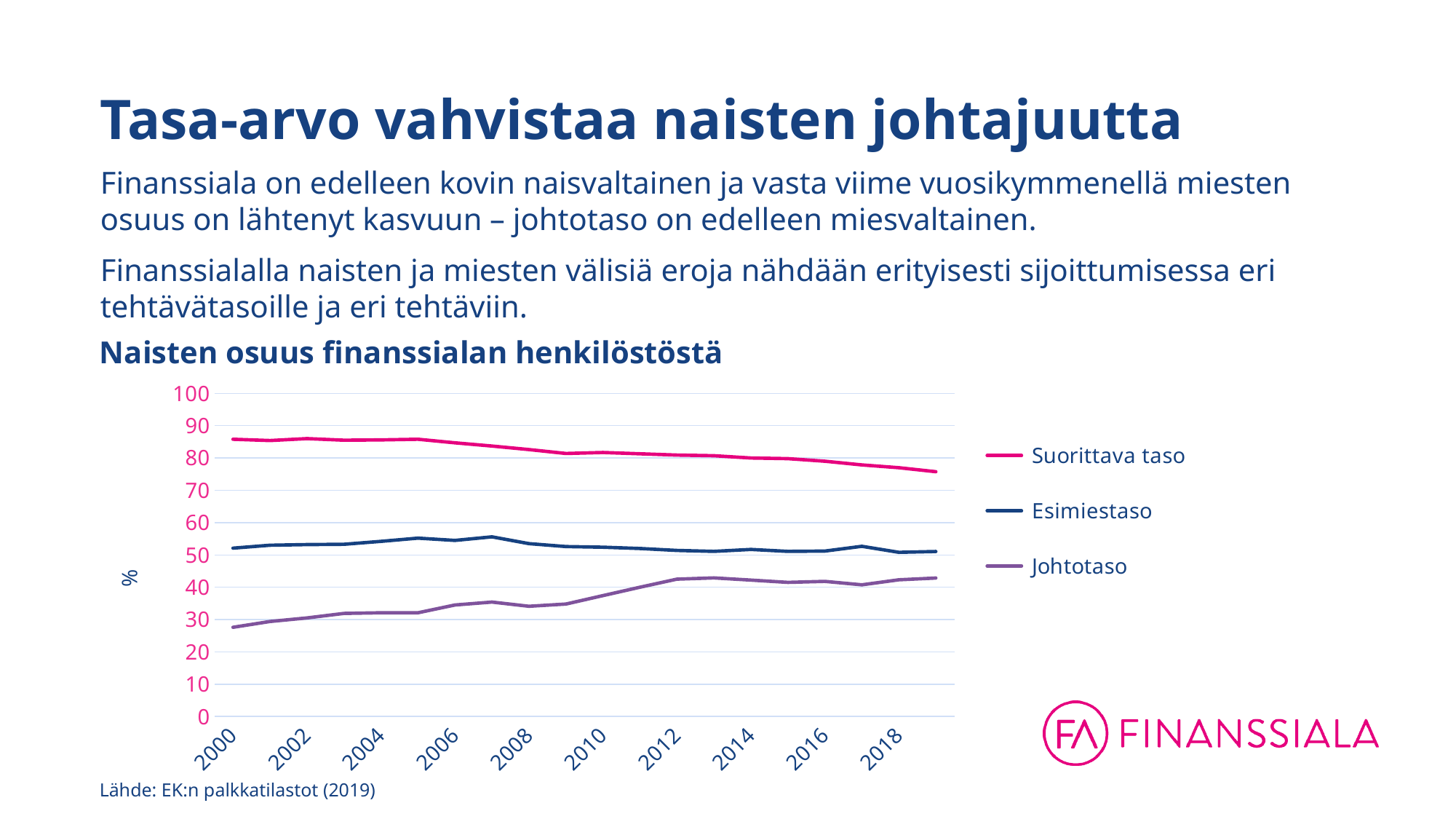
How many series does the chart legend list? 3 Is the value for Johtotaso in 2000 greater or less than 30? less What kind of chart is shown on the slide? line chart What is the title of the chart? Naisten osuus finanssialan henkilöstöstä Is the value for Suorittava taso in 2000 greater or less than 80? greater Does the Johtotaso line rise or fall from 2000 to the end of the period? rise Is the value for Johtotaso in 2018 greater or less than 40? greater Which series has the highest value in 2018? Suorittava taso In 2010, which series has the higher value, Esimiestaso or Johtotaso? Esimiestaso Which series has the lowest value in 2000? Johtotaso Does the Suorittava taso line rise or fall from 2000 to the end of the period? fall